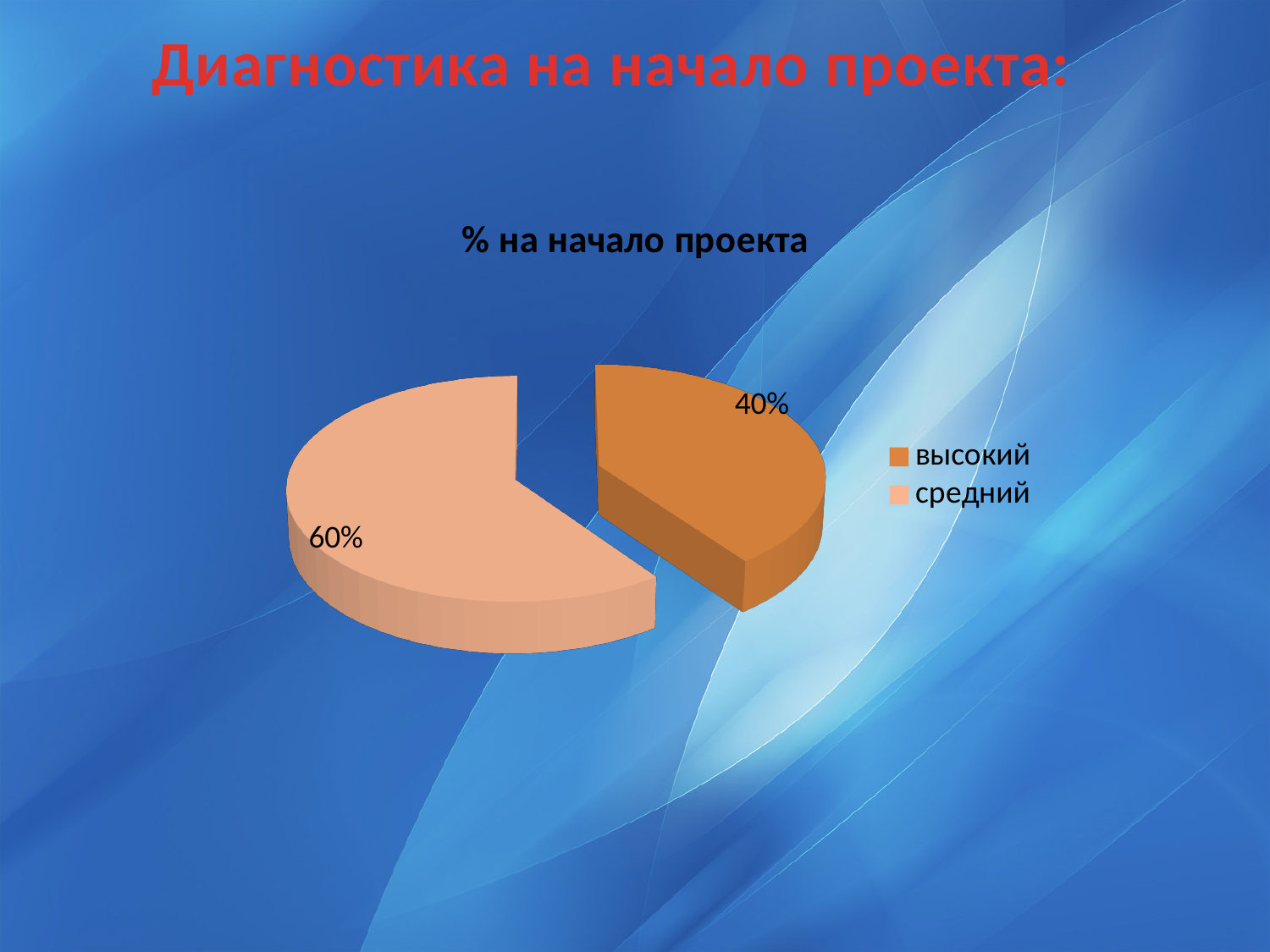
Which legend entry is shown in the darker orange colour? высокий What is the title of the chart? % на начало проекта How many categories does the legend list? 2 Which category has the largest share of the pie? средний What is the difference between the 'средний' and 'высокий' shares? 20% Which is larger, the share for 'высокий' or for 'средний'? средний What percentage is shown for the 'высокий' slice? 40% What kind of chart is shown on the slide? pie chart What percentage is shown for the 'средний' slice? 60% What share of the pie does the 'средний' slice represent? 60% Which category has the smallest share of the pie? высокий